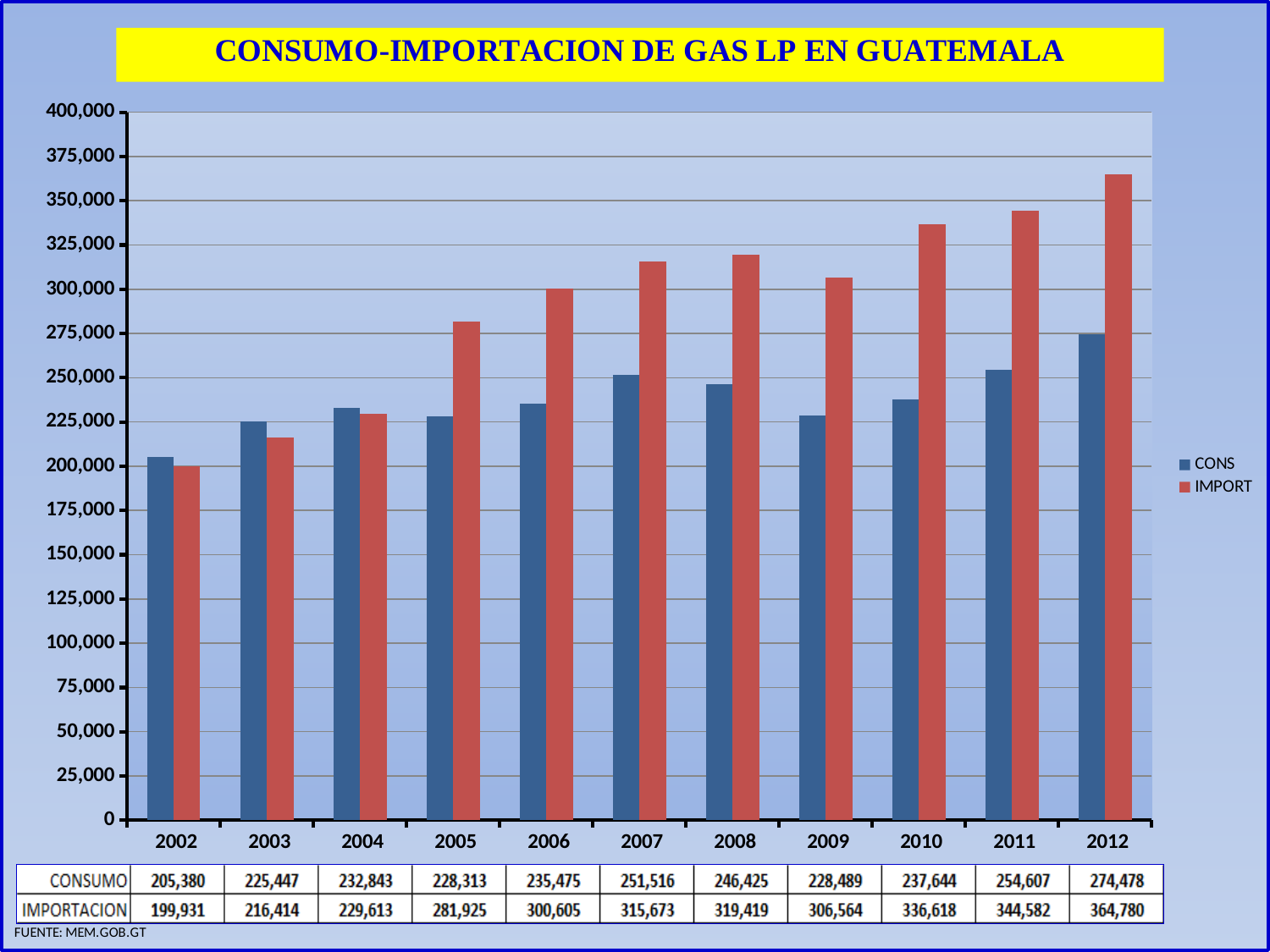
What is the difference between CONSUMO and IMPORTACION in 2002? 5,449 Does the IMPORT series rise or fall from 2009 to 2012? Rise In which year is the CONSUMO value lowest? 2002 What is the IMPORTACION value for 2005? 281,925 What kind of chart is shown on the slide? Bar chart In which year is the IMPORTACION value highest? 2012 What is the difference between IMPORTACION and CONSUMO in 2012? 90,302 In 2004, which is larger, CONSUMO or IMPORTACION? CONSUMO What is the CONSUMO value for 2007? 251,516 What is the CONSUMO value for 2012? 274,478 How many years are shown on the x axis? 11 How many series does the legend list? 2